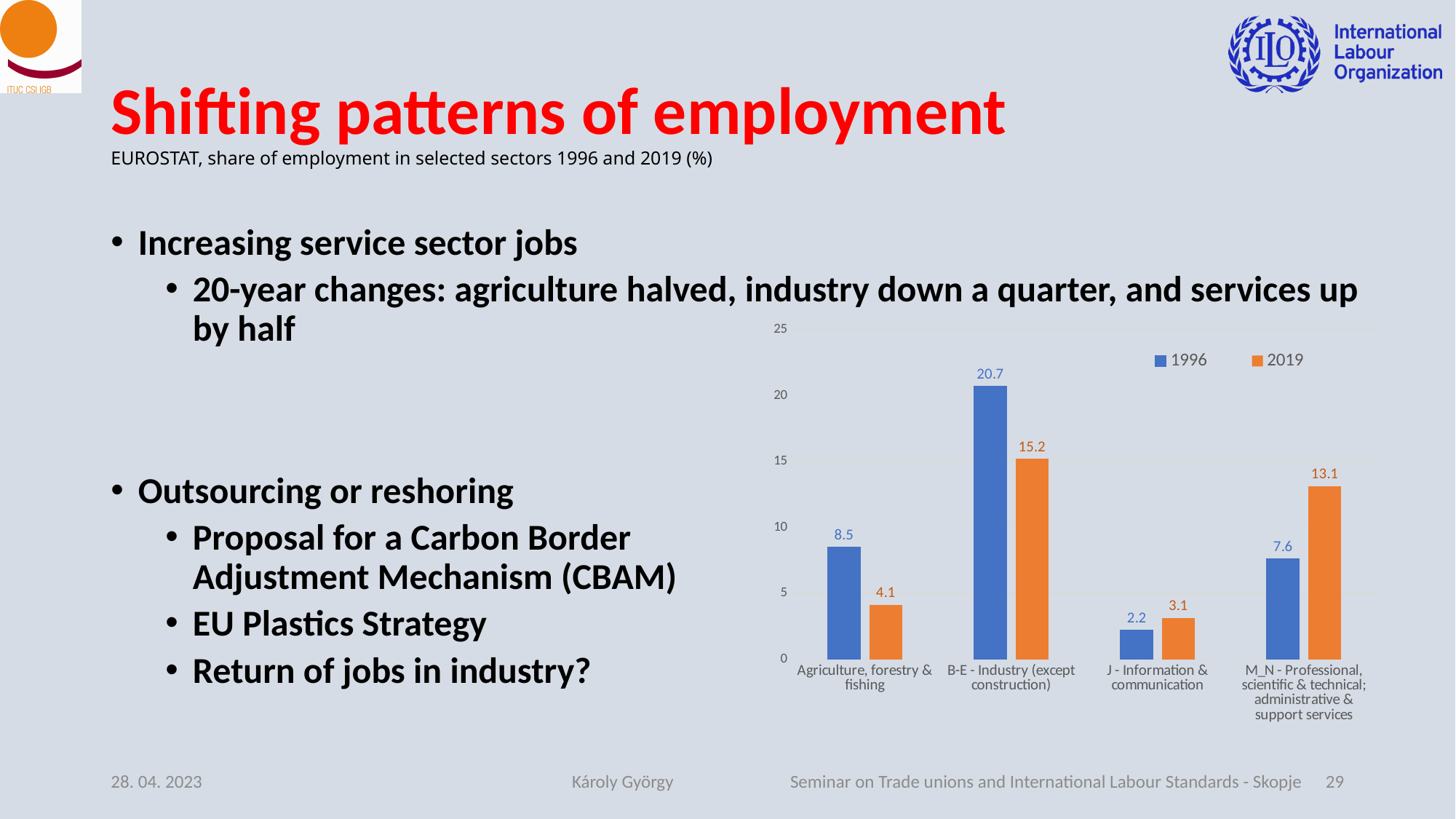
Which category has the highest 1996 value? B-E - Industry (except construction) What kind of chart is shown on the slide? bar chart Which colour represents the 2019 series in the legend? orange How many series does the legend list? 2 What is the difference between the 1996 and 2019 values for B-E - Industry (except construction)? 5.5 What is the 2019 value for Agriculture, forestry & fishing? 4.1 What is the 2019 value for M_N - Professional, scientific & technical; administrative & support services? 13.1 Which is larger for J - Information & communication: the 1996 value or the 2019 value? 2019 Is the 1996 value for Agriculture, forestry & fishing greater or less than 10? less What is the 1996 value for B-E - Industry (except construction)? 20.7 Which category has the lowest 2019 value? J - Information & communication How many categories are shown on the x axis? 4